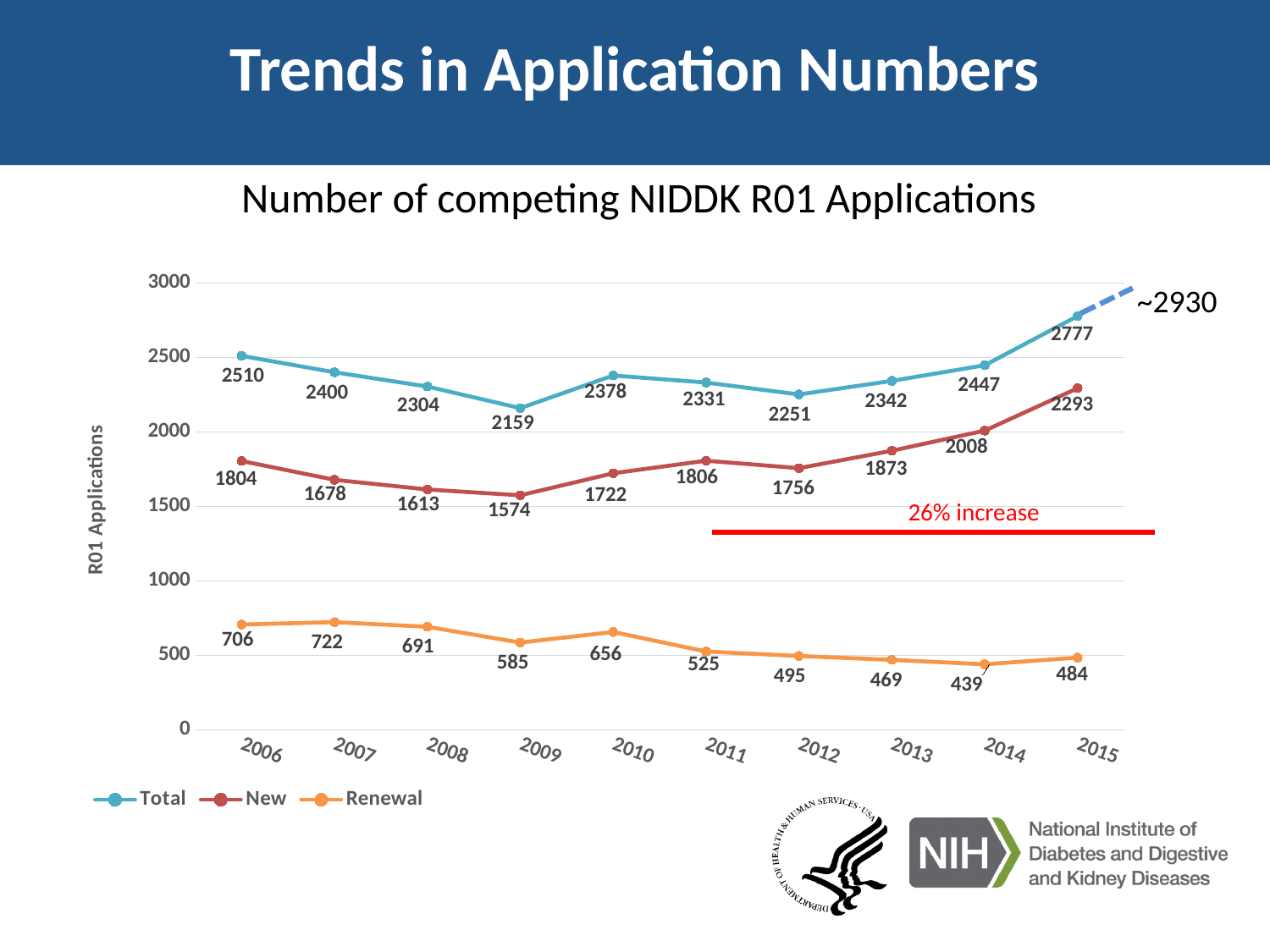
What is the title of the chart? Number of competing NIDDK R01 Applications How many series does the legend list? 3 In which year was the Total number of applications lowest? 2009 What kind of chart is shown on the slide? Line chart What was the number of Renewal applications in 2014? 439 What was the number of New applications in 2009? 1574 How many years are shown on the x axis? 10 Did the number of Renewal applications generally rise or fall from 2006 to 2014? Fall What was the Total number of competing NIDDK R01 applications in 2015? 2777 What is the difference between the Total applications in 2015 and in 2014? 330 Which was larger, the number of Renewal applications in 2007 or in 2008? 2007 In which year was the number of New applications highest? 2015